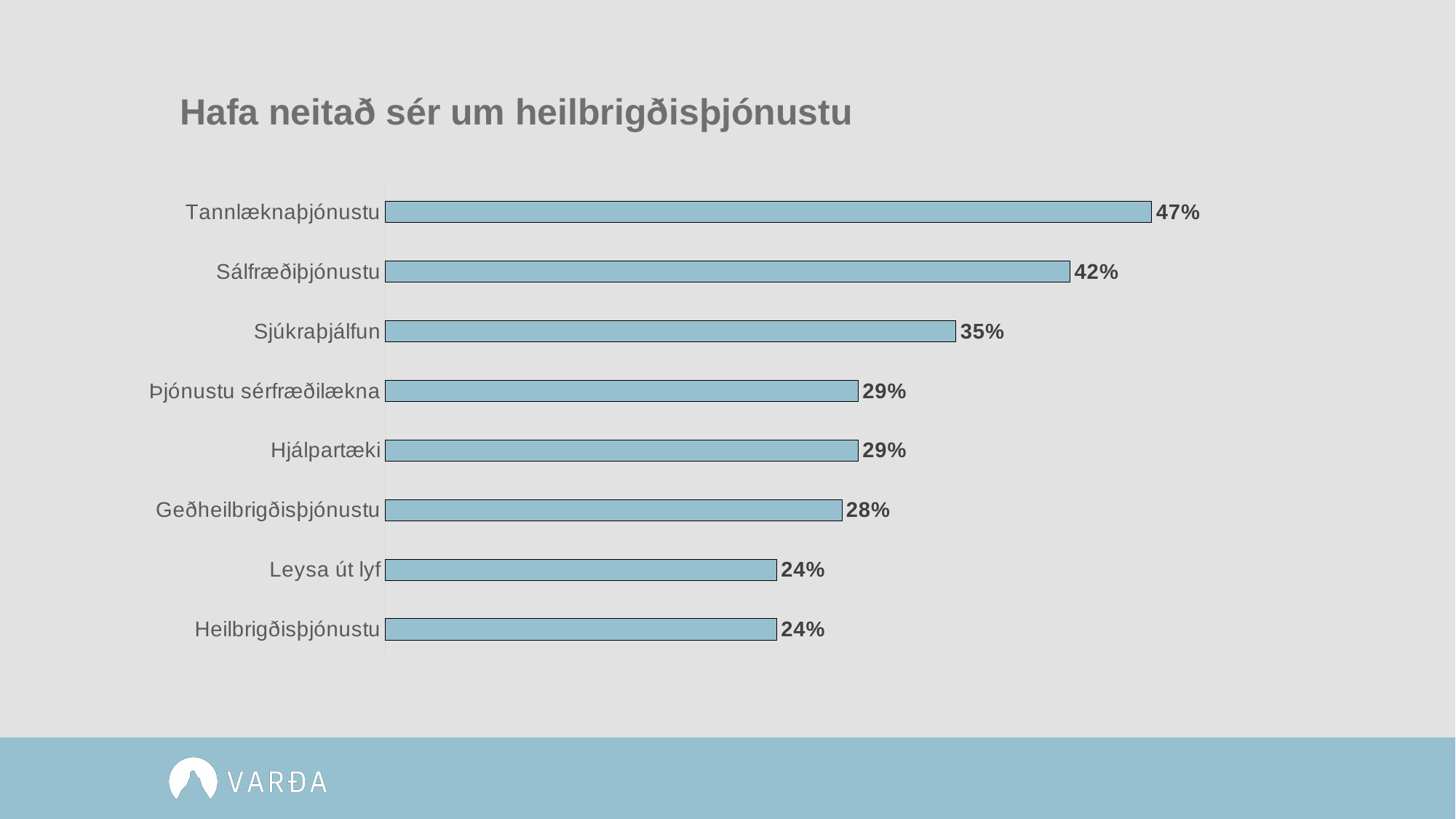
Which is larger, the value for Geðheilbrigðisþjónustu or the value for Leysa út lyf? Geðheilbrigðisþjónustu What is the value for Sjúkraþjálfun? 35% What is the difference between the values for Tannlæknaþjónustu and Sálfræðiþjónustu? 5% What is the value for Geðheilbrigðisþjónustu? 28% What is the difference between the values for Sjúkraþjálfun and Heilbrigðisþjónustu? 11% What is the value for Leysa út lyf? 24% What is the value for Tannlæknaþjónustu? 47% How many categories are shown in the chart? 8 What kind of chart is shown on the slide? Bar chart What is the title of the chart? Hafa neitað sér um heilbrigðisþjónustu Which category has the highest value? Tannlæknaþjónustu Which is larger, the value for Sálfræðiþjónustu or the value for Sjúkraþjálfun? Sálfræðiþjónustu